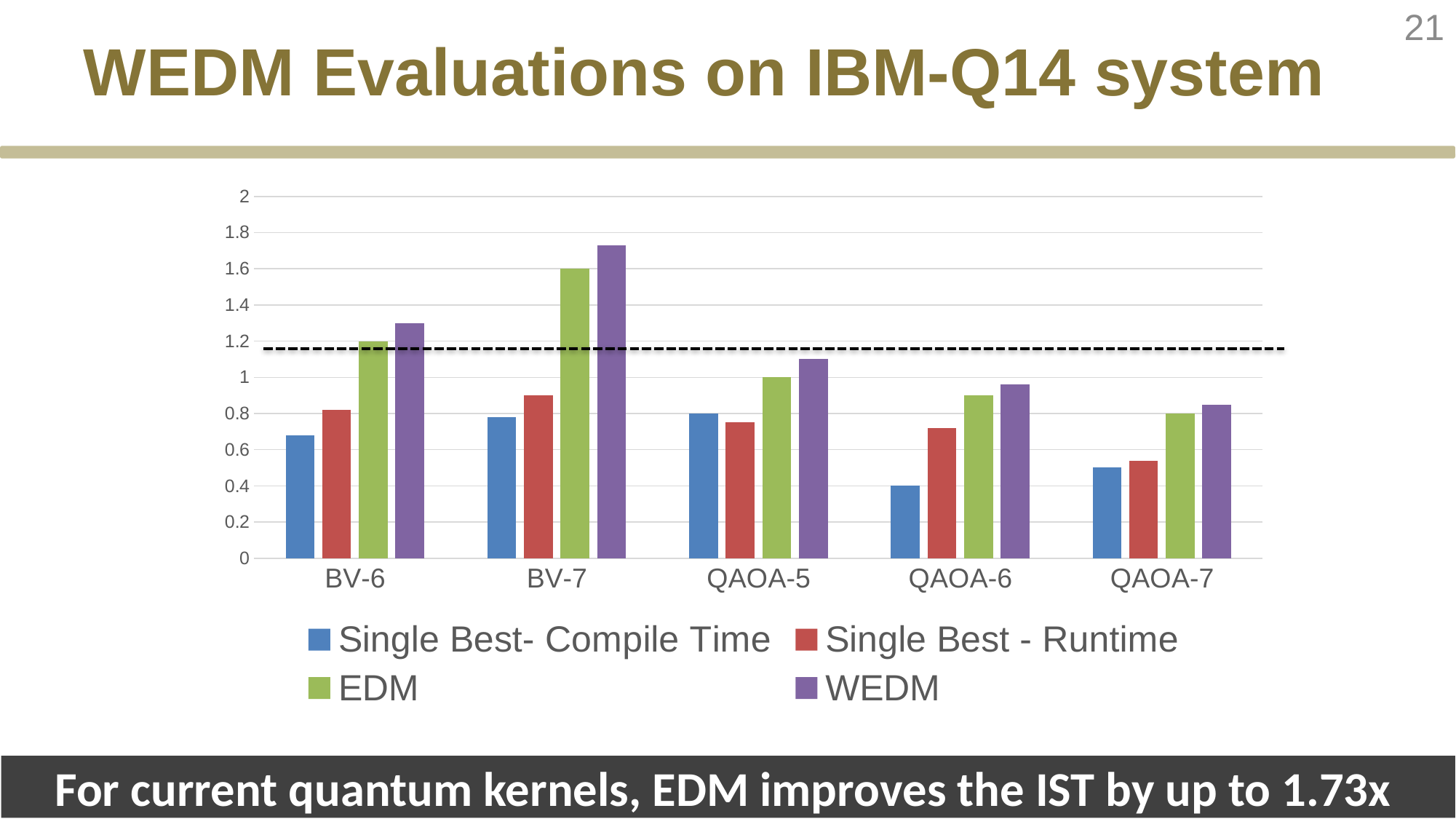
Is the Single Best- Compile Time value for QAOA-7 greater or less than 0.6? less Which is larger for BV-6: the EDM value or the Single Best - Runtime value? EDM Which benchmark has the lowest Single Best- Compile Time value? QAOA-6 Is the WEDM value for BV-7 greater or less than 1.6? greater How many series does the legend list? 4 Is the WEDM value for QAOA-5 greater or less than 1? greater Which series is shown in green in the legend? EDM What kind of chart is shown on the slide? bar chart How many categories (benchmarks) are shown on the x axis? 5 Which benchmark has the highest WEDM value? BV-7 Which series is shown in purple in the legend? WEDM